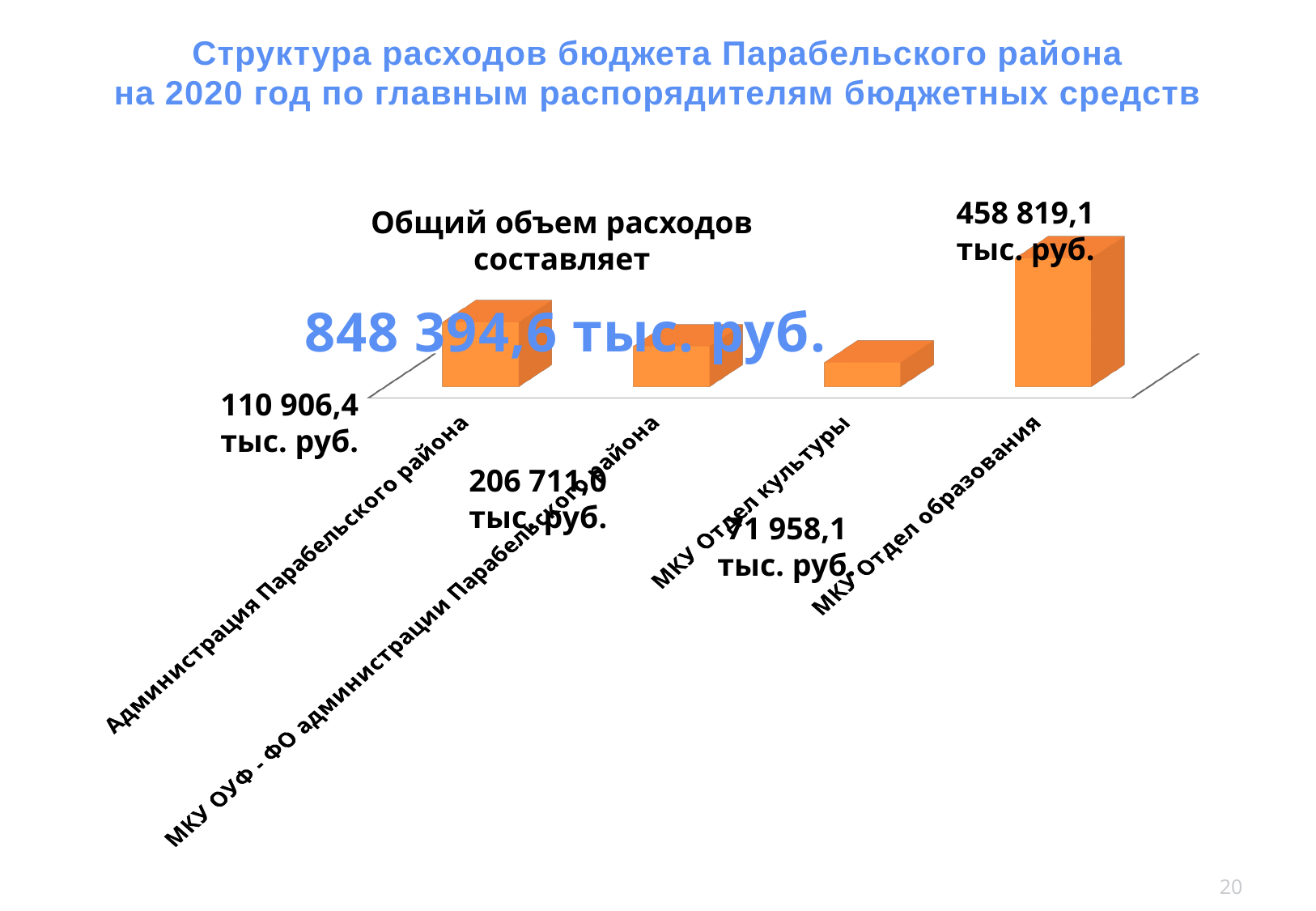
What year does the chart title say the budget expenditure structure refers to? 2020 What colour are the bars in the chart? orange What is the expenditure value shown for МКУ Отдел культуры? 71 958,1 тыс. руб. What is the difference between the expenditure of МКУ Отдел образования and МКУ Отдел культуры? 386 861,0 тыс. руб. What kind of chart is shown on the slide? bar chart How many categories (main budget administrators) are shown in the chart? 4 Which category has the lowest expenditure in the chart? МКУ Отдел культуры Which is larger: the expenditure of МКУ Отдел образования or of Администрация Парабельского района? МКУ Отдел образования What is the expenditure value shown for МКУ Отдел образования? 458 819,1 тыс. руб. What is the total volume of expenditures stated on the slide? 848 394,6 тыс. руб. Which category has the highest expenditure in the chart? МКУ Отдел образования